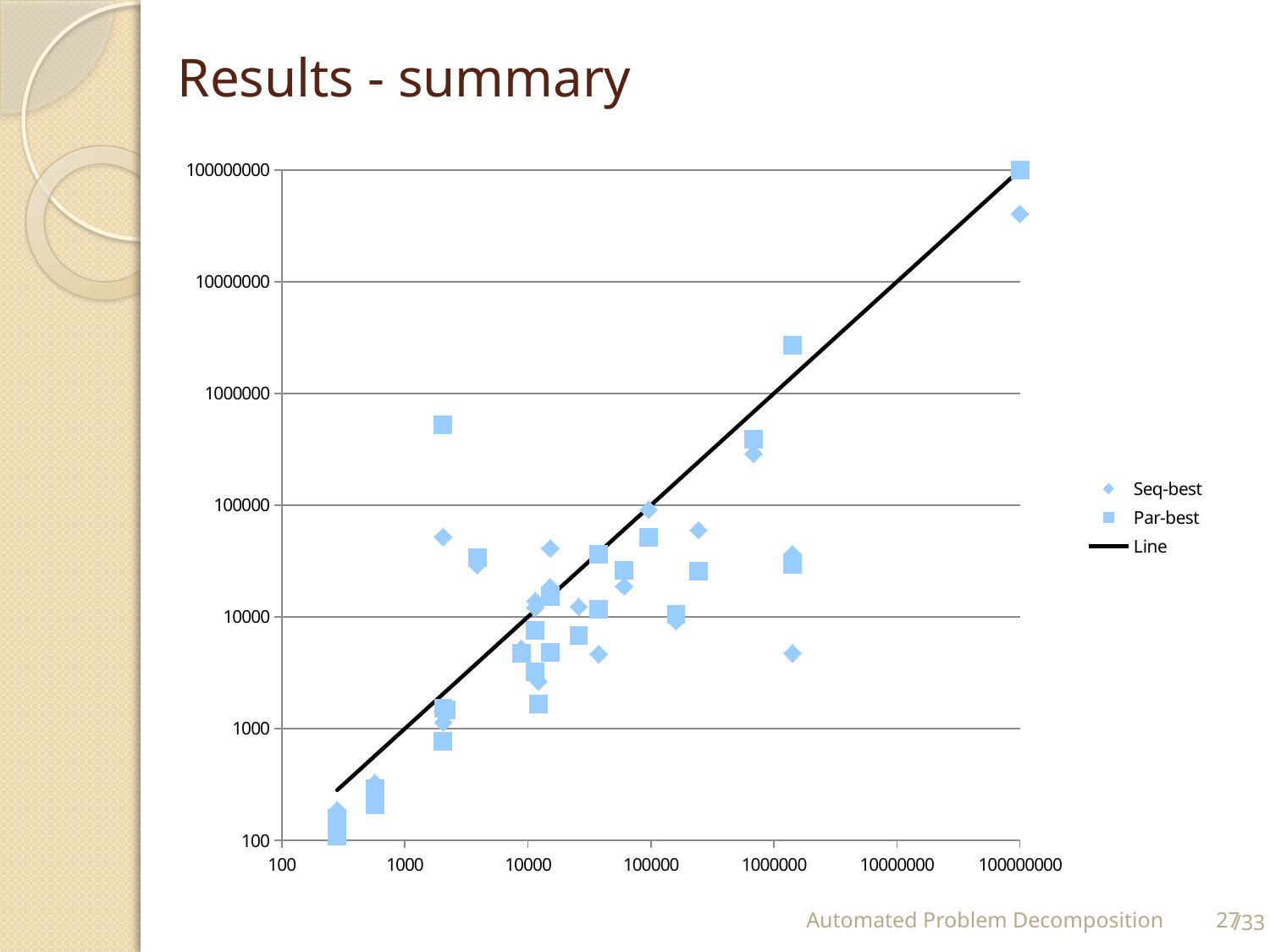
Is the y value of the Par-best point near x = 2000 that lies far above the line greater or less than 100000? greater What is the highest value shown on the y axis? 100000000 What are the entries listed in the chart legend? Seq-best, Par-best, Line What is the lowest value shown on the x axis? 100 What kind of chart is shown on the slide? scatter chart How many series does the legend list? 3 Is the y value of the highest Seq-best point greater or less than 10000000? greater Does the black Line series rise or fall as the x axis increases? rise Is the y value of the lowest plotted point greater or less than 1000? less